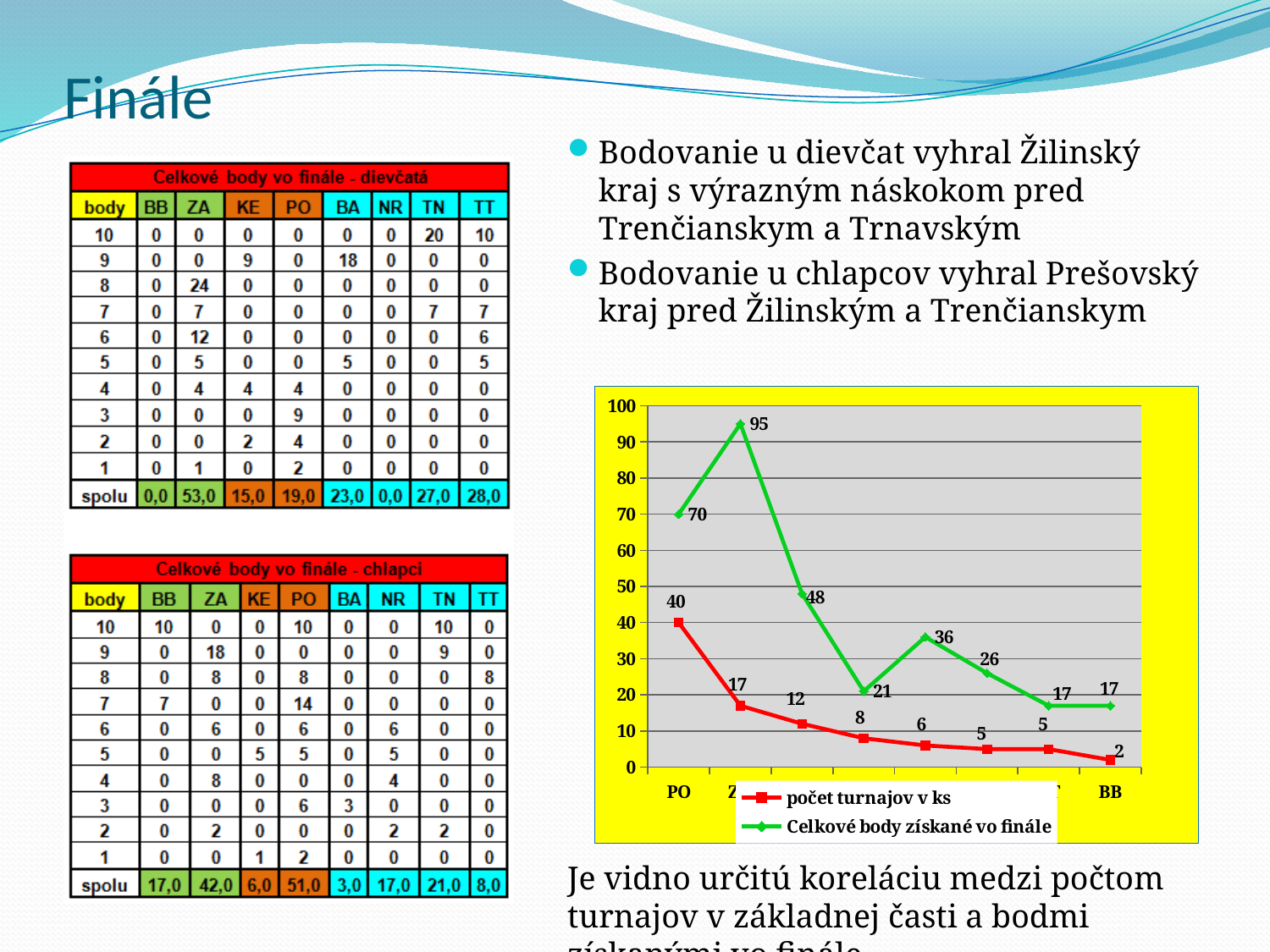
What is the value of 'Celkové body získané vo finále' for BB? 17 How many data points does each series in the chart have? 8 What is the value of 'počet turnajov v ks' for BB? 2 What is the value of 'počet turnajov v ks' for PO? 40 Which category has the lowest value for 'počet turnajov v ks'? BB Which category has the highest value for 'počet turnajov v ks'? PO What is the highest value plotted for 'Celkové body získané vo finále'? 95 How many series does the chart legend list? 2 Does the 'počet turnajov v ks' series rise or fall from PO to BB along the x axis? fall For PO, what is the difference between 'Celkové body získané vo finále' and 'počet turnajov v ks'? 30 What kind of chart is shown on the slide? line chart What is the value of 'Celkové body získané vo finále' for PO? 70